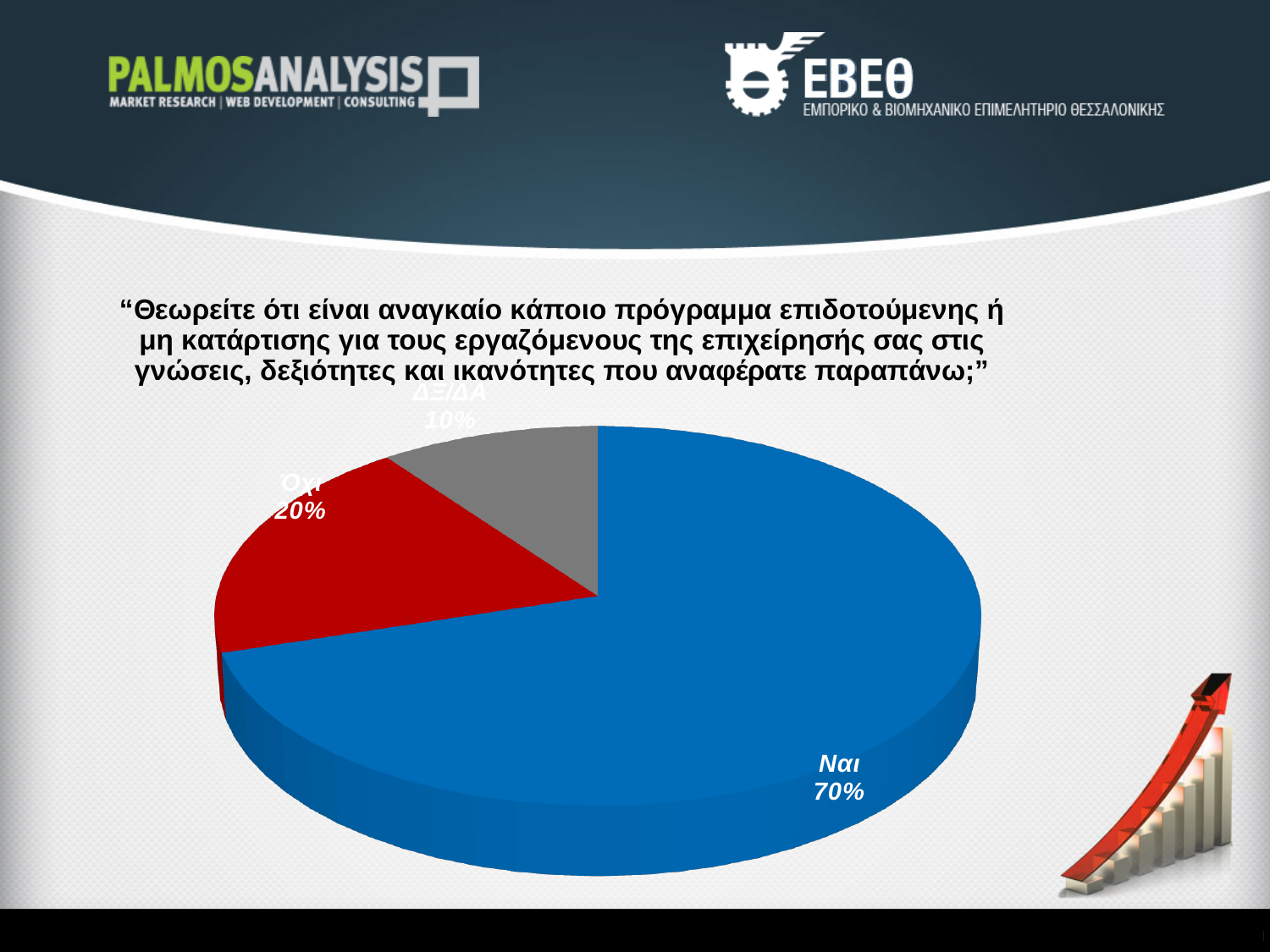
Which is larger, the share for "Όχι" or the share for "ΔΞ/ΔΑ"? Όχι Which response has the largest share of the pie? Ναι What kind of chart is shown on the slide? pie chart What is the difference in percentage points between "Όχι" and "ΔΞ/ΔΑ"? 10 How many slices does the pie chart have? 3 What colour is the "Όχι" slice of the pie? red Which response has the smallest share of the pie? ΔΞ/ΔΑ What percentage of respondents answered "ΔΞ/ΔΑ"? 10% What percentage of respondents answered "Όχι"? 20% What is the difference in percentage points between "Ναι" and "Όχι"? 50 What percentage of respondents answered "Ναι"? 70% What colour is the "Ναι" slice of the pie? blue